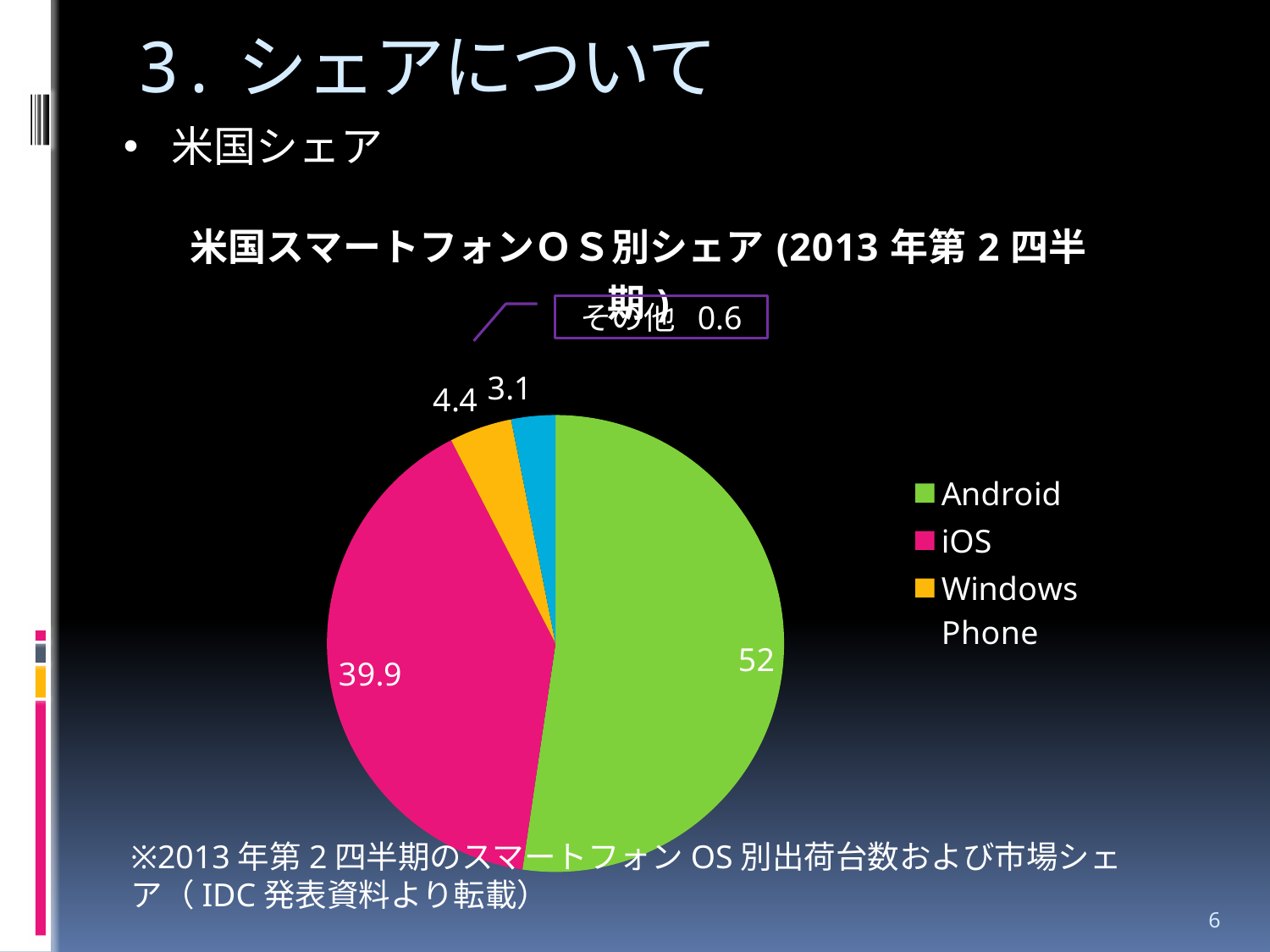
How many entries does the legend list? 3 Which category has the largest slice of the pie chart? Android What is the value shown for Android in the pie chart? 52 What kind of chart is shown on the slide? pie chart Which labeled category has the smallest slice of the pie chart? その他 What is the value shown for その他 in the pie chart? 0.6 What is the value shown for Windows Phone in the pie chart? 4.4 What is the difference between the Android value and the iOS value? 12.1 What is the value shown for iOS in the pie chart? 39.9 What colour is the iOS slice in the pie chart? pink Which is larger, the iOS slice or the Windows Phone slice? iOS